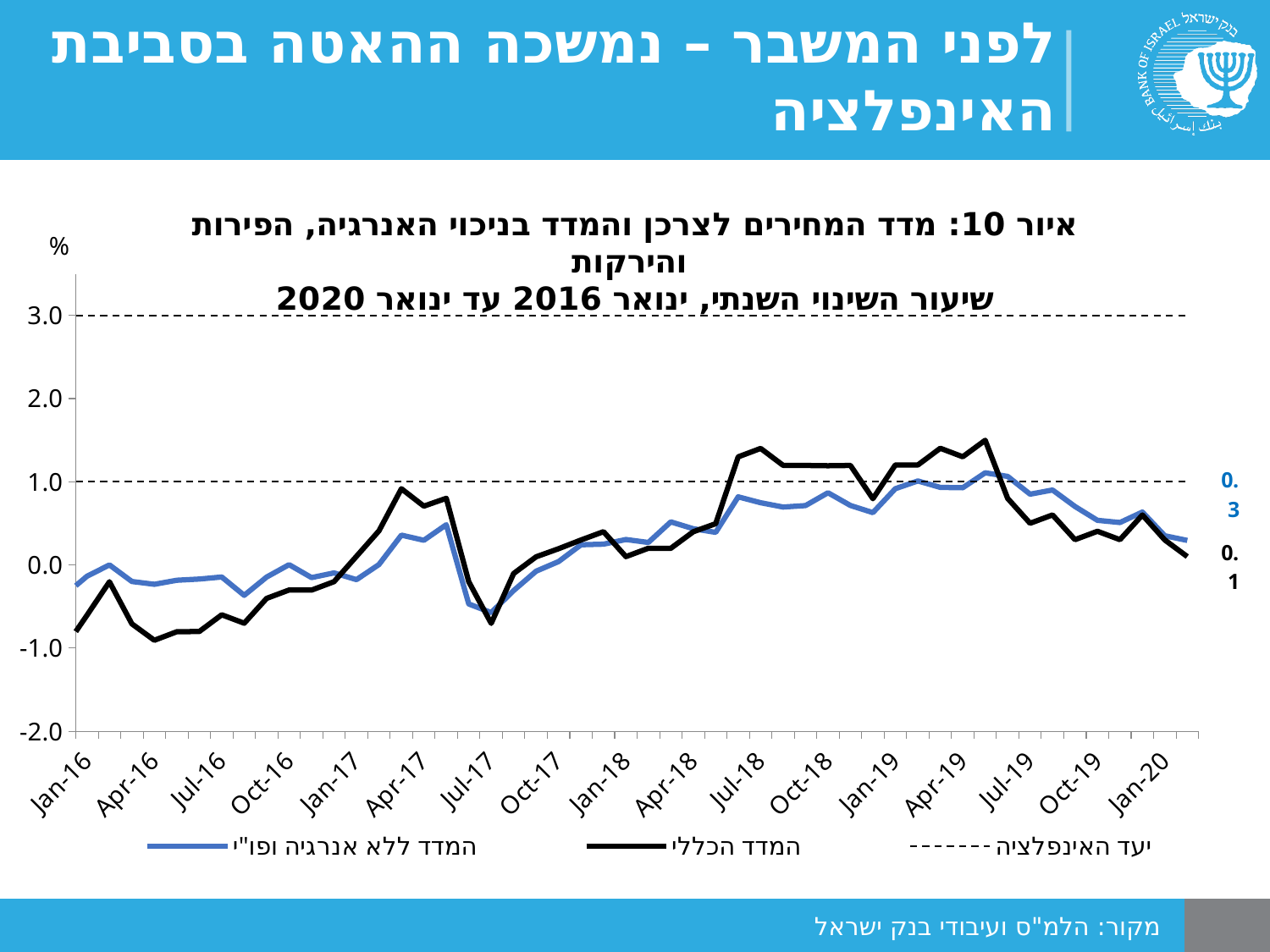
At the end of the chart, which series has the higher value: המדד הכללי or המדד ללא אנרגיה ופו"י? המדד ללא אנרגיה ופו"י What is the value of the blue series (המדד ללא אנרגיה ופו"י) at the end of the chart, as printed on the data label? 0.3 What is the difference between the final labelled values of the blue series (0.3) and the black series (0.1)? 0.2 Is the value of the black series (המדד הכללי) at Apr-16 greater or less than 0.0? less Between Jul-19 and Jan-20, does the black series (המדד הכללי) generally rise or fall? fall What is the value of the black series (המדד הכללי) at the end of the chart, as printed on the data label? 0.1 At Jan-16, which series has the higher value: המדד הכללי or המדד ללא אנרגיה ופו"י? המדד ללא אנרגיה ופו"י How many series does the legend list? 3 Is the value of the black series (המדד הכללי) at Jul-18 greater or less than 1.0? greater Which legend entry is drawn as a dashed line? יעד האינפלציה What kind of chart is shown on the slide? line chart Is the value of the blue series (המדד ללא אנרגיה ופו"י) at Jul-17 greater or less than 0.0? less